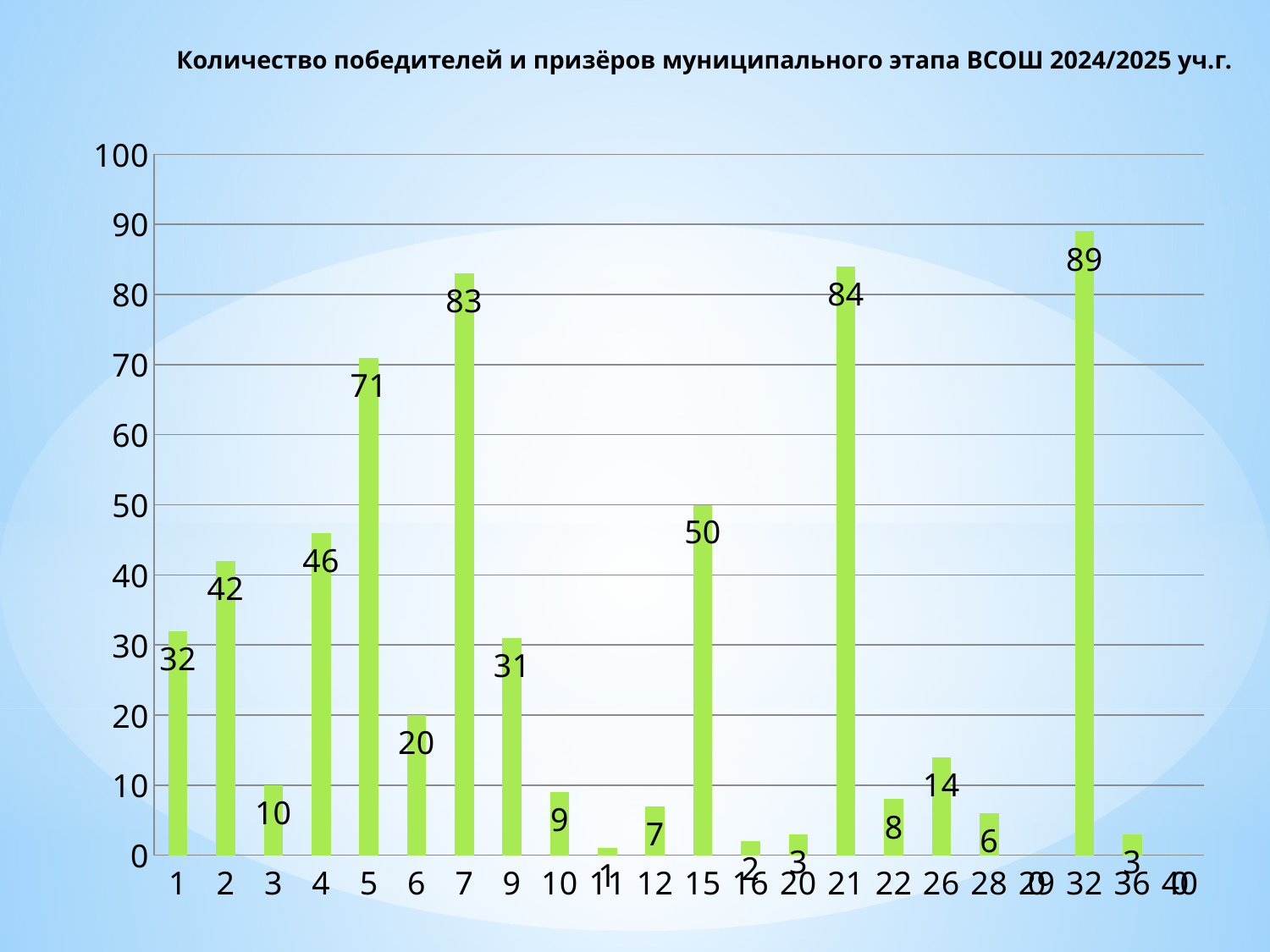
What is the difference between the values for categories 32 and 21? 5 What kind of chart is shown on the slide? bar chart What is the value for category 26? 14 What is the value for category 7? 83 What is the value for category 15? 50 Which has the larger value, category 2 or category 4? 4 What is the value for category 1? 32 What is the title of the chart? Количество победителей и призёров муниципального этапа ВСОШ 2024/2025 уч.г. What is the difference between the values for categories 7 and 5? 12 What is the value for category 21? 84 Which has the larger value, category 7 or category 21? 21 Which category has the highest value? 32